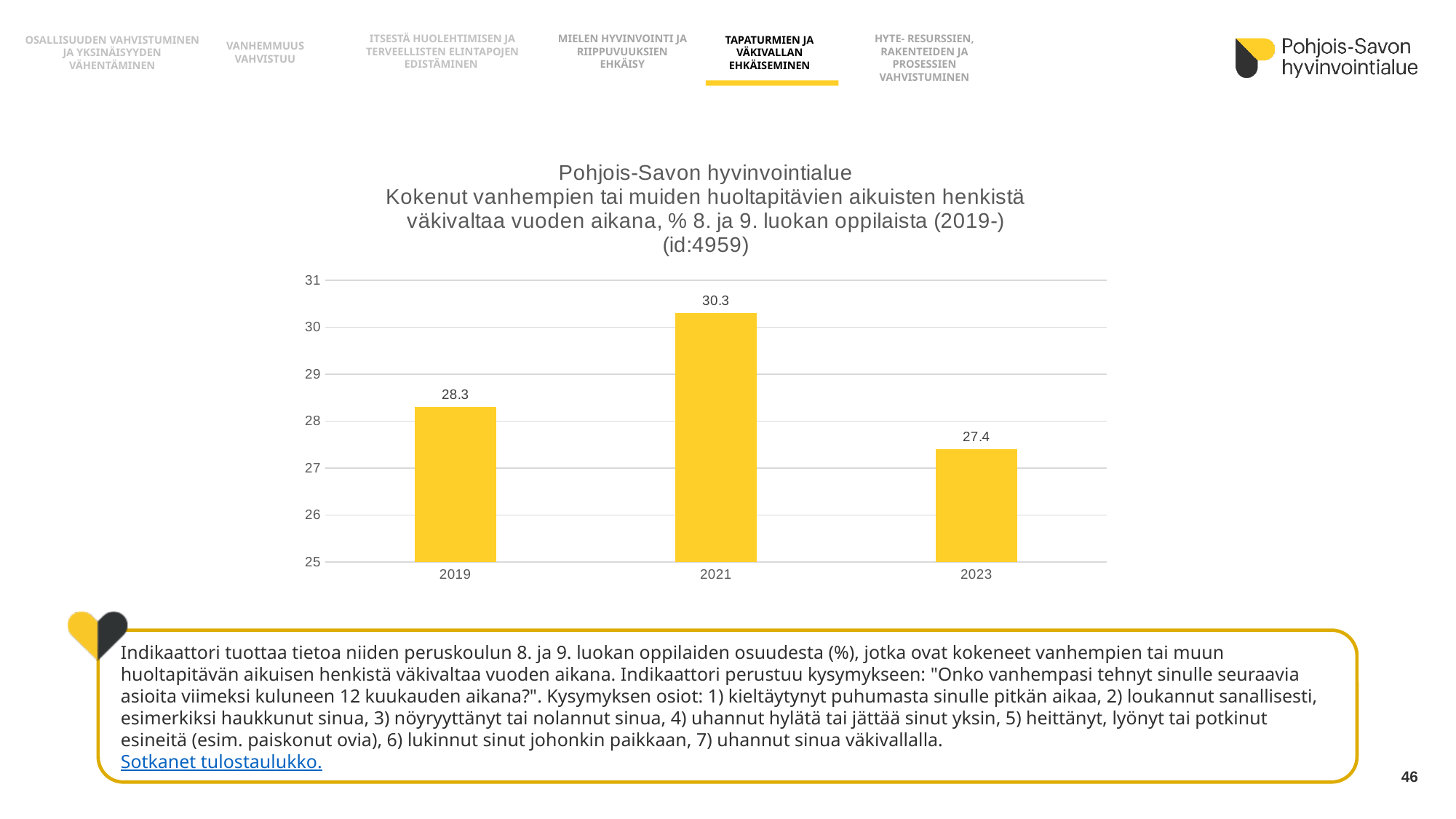
What is the value for 2023? 27.4 What is the value for 2019? 28.3 What is the difference between the values for 2019 and 2023? 0.9 Is the value for 2021 greater or less than 30? greater Which year has the lowest value? 2023 How many years are shown on the x axis? 3 What is the difference between the values for 2021 and 2019? 2.0 Which is larger, the value for 2019 or the value for 2023? 2019 What kind of chart is shown on the slide? Bar chart Which year has the highest value? 2021 What is the indicator id shown in the chart title? 4959 What is the value for 2021? 30.3